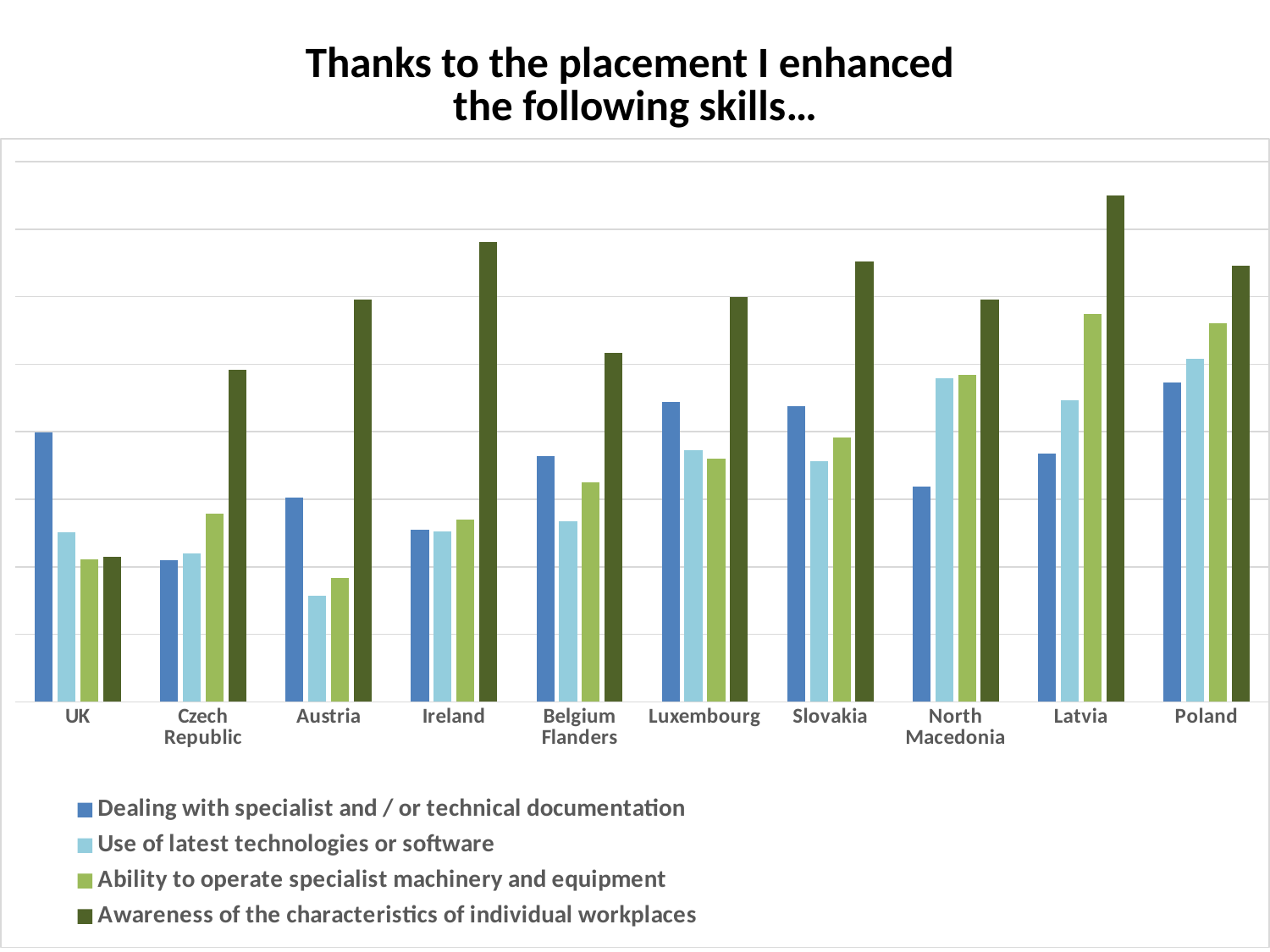
For North Macedonia, which is larger: 'Dealing with specialist and / or technical documentation' or 'Use of latest technologies or software'? Use of latest technologies or software Which country has the shortest bar for 'Awareness of the characteristics of individual workplaces'? UK Does the 'Awareness of the characteristics of individual workplaces' series rise or fall from UK to Ireland? rise Which country has the shortest bar for 'Use of latest technologies or software'? Austria What is the title of the chart? Thanks to the placement I enhanced the following skills… For the UK, which skill has the tallest bar? Dealing with specialist and / or technical documentation How many series does the legend list? 4 Which country has the tallest bar for 'Awareness of the characteristics of individual workplaces'? Latvia For Ireland, which skill has the tallest bar? Awareness of the characteristics of individual workplaces How many countries/regions are shown on the x axis? 10 What kind of chart is shown on the slide? bar chart